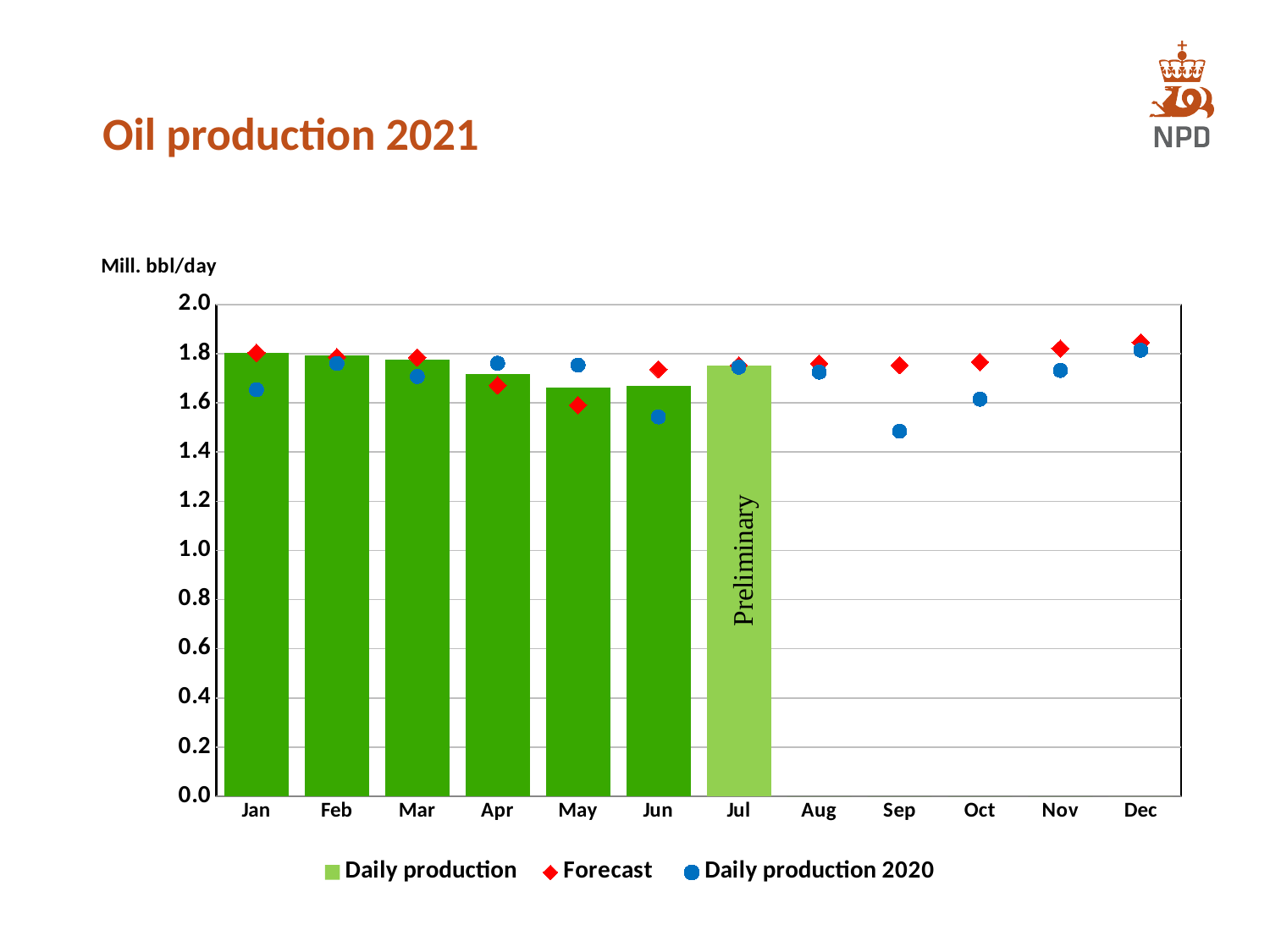
Which month has the lowest Daily production 2020 value? Sep Which month's bar is labelled 'Preliminary'? Jul How many series does the legend list? 3 Is the Forecast value for Dec greater or less than 1.8? greater Is the Daily production 2020 value for Sep greater or less than 1.6? less How many months have a Daily production bar plotted? 7 What kind of chart is shown on the slide? Bar chart with point markers What is the title of the chart? Oil production 2021 In Jan, which is larger: the Daily production bar or the Daily production 2020 point? Daily production Which month has the highest Forecast value? Dec Is the Daily production value for Jan greater or less than 1.6? greater Do the Daily production 2020 values rise or fall from Jul to Sep? fall